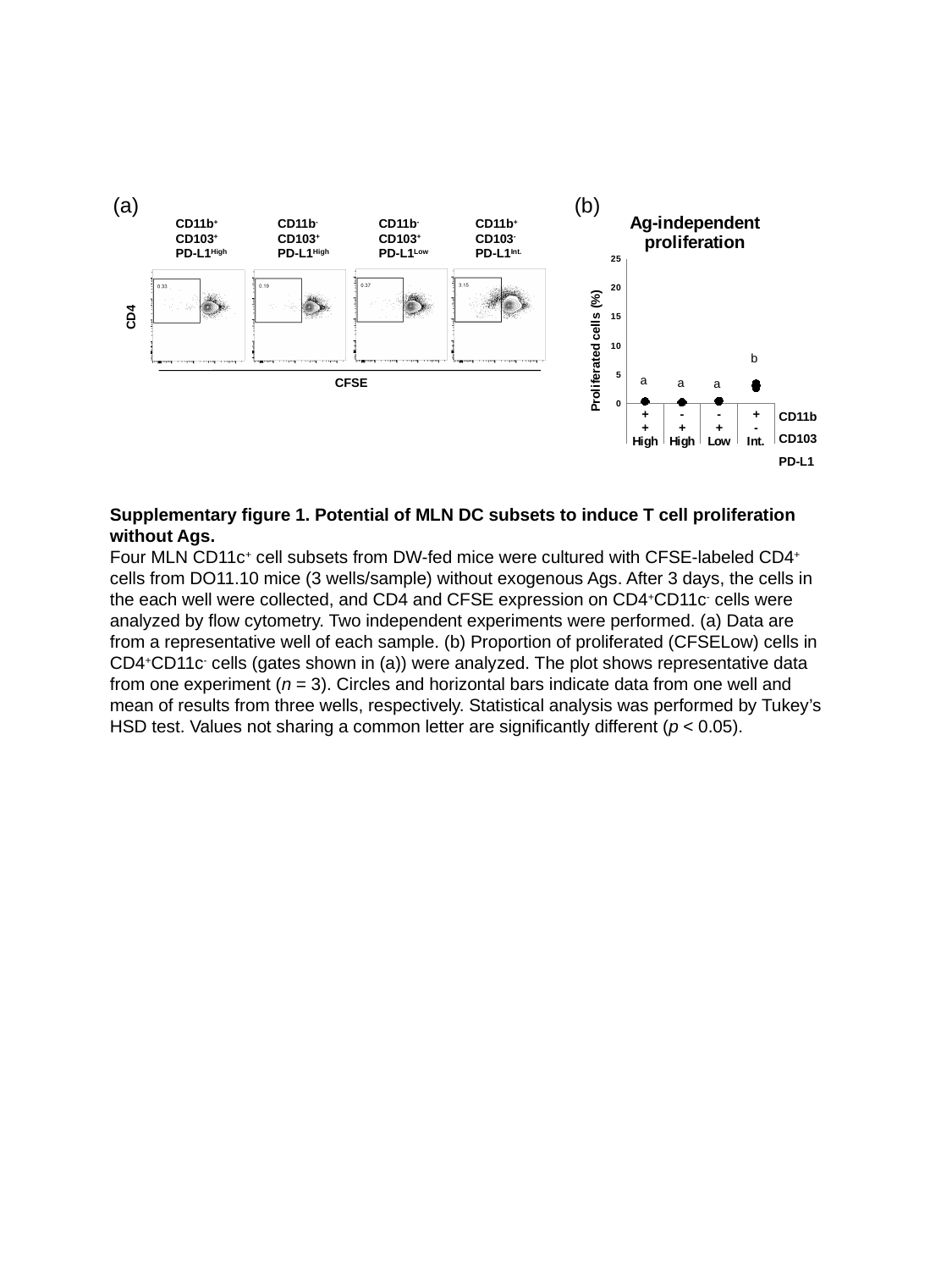
How many DC subset groups are plotted along the x axis of the chart in panel (b)? 4 In the chart in panel (b), is the value for the CD11b+ CD103- PD-L1 Int. group greater or less than 5? less In the chart in panel (b), is the value for the CD11b+ CD103+ PD-L1 High group greater or less than 5? less In panel (a), what gate percentage is printed in the CD11b- CD103+ PD-L1 High flow cytometry plot? 0.19 What is the y-axis label of the chart in panel (b)? Proliferated cells (%) In panel (a), what gate percentage is printed in the CD11b+ CD103- PD-L1 Int. flow cytometry plot? 3.15 What is the highest tick value on the y axis of the chart in panel (b)? 25 In panel (a), what gate percentage is printed in the CD11b+ CD103+ PD-L1 High flow cytometry plot? 0.33 What is the title of the chart in panel (b)? Ag-independent proliferation In the chart in panel (b), which group shows the highest proportion of proliferated cells? CD11b+ CD103- PD-L1 Int. In panel (a), which of the four flow cytometry plots shows the highest gate percentage? CD11b+ CD103- PD-L1 Int. In the chart in panel (b), which is larger: the value for the CD11b- CD103+ PD-L1 Low group or the CD11b+ CD103- PD-L1 Int. group? CD11b+ CD103- PD-L1 Int.